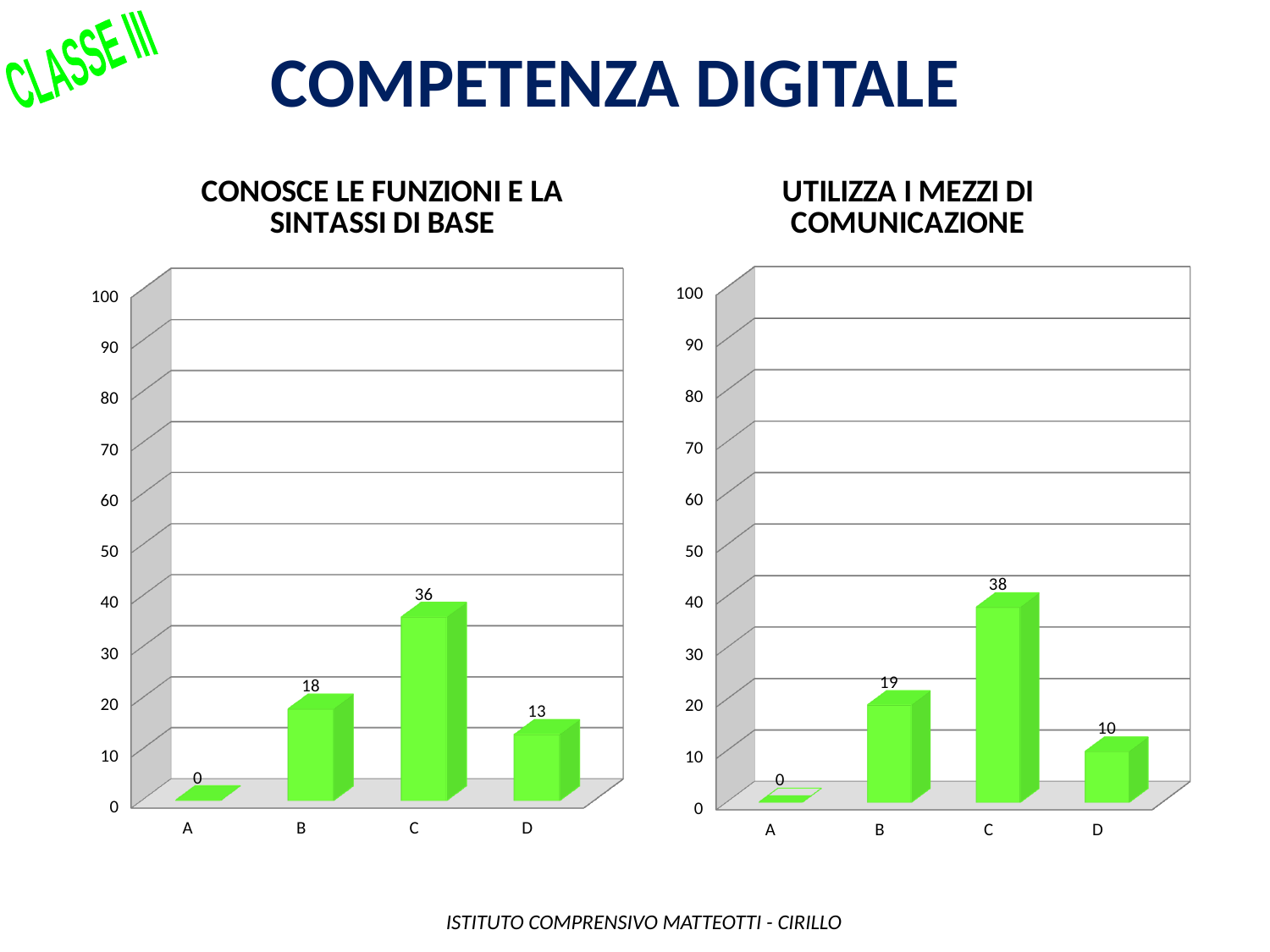
In the chart titled 'UTILIZZA I MEZZI DI COMUNICAZIONE', which category has the lowest value? A In the chart titled 'CONOSCE LE FUNZIONI E LA SINTASSI DI BASE', what is the value for category C? 36 How many categories are shown in the chart titled 'CONOSCE LE FUNZIONI E LA SINTASSI DI BASE'? 4 In the chart titled 'CONOSCE LE FUNZIONI E LA SINTASSI DI BASE', which category has the highest value? C In the chart titled 'UTILIZZA I MEZZI DI COMUNICAZIONE', is the value for C greater or less than 30? greater In the chart titled 'UTILIZZA I MEZZI DI COMUNICAZIONE', what is the difference between the values for C and D? 28 In the chart titled 'CONOSCE LE FUNZIONI E LA SINTASSI DI BASE', which is larger, the value for B or the value for D? B In the chart titled 'UTILIZZA I MEZZI DI COMUNICAZIONE', what is the value for category B? 19 What is the title of the chart on the left side of the slide? CONOSCE LE FUNZIONI E LA SINTASSI DI BASE What kind of chart is the chart titled 'UTILIZZA I MEZZI DI COMUNICAZIONE'? bar chart In the chart titled 'UTILIZZA I MEZZI DI COMUNICAZIONE', what is the value for category D? 10 In the chart titled 'CONOSCE LE FUNZIONI E LA SINTASSI DI BASE', what is the difference between the values for C and B? 18